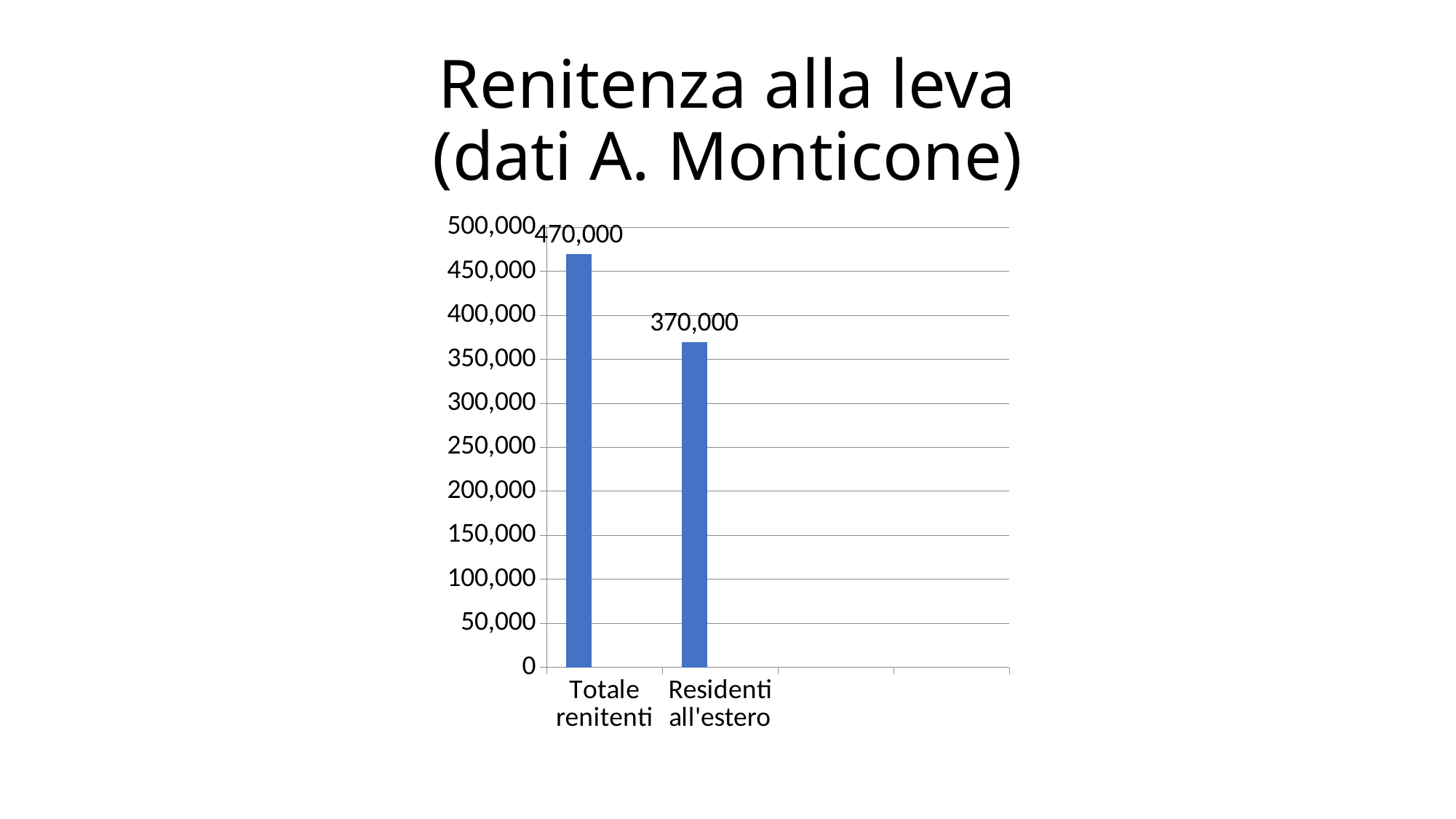
Is the value for Totale renitenti greater or less than 450,000? greater How many categories are shown in the chart? 2 Is the value for Residenti all'estero greater or less than 400,000? less Which category has the lowest value? Residenti all'estero What is the highest value shown on the vertical axis? 500,000 What is the difference between Totale renitenti and Residenti all'estero? 100,000 What is the title of the slide? Renitenza alla leva (dati A. Monticone) Which is larger, Totale renitenti or Residenti all'estero? Totale renitenti What is the value for Totale renitenti? 470,000 Which category has the highest value? Totale renitenti What kind of chart is shown on the slide? bar chart What is the value for Residenti all'estero? 370,000